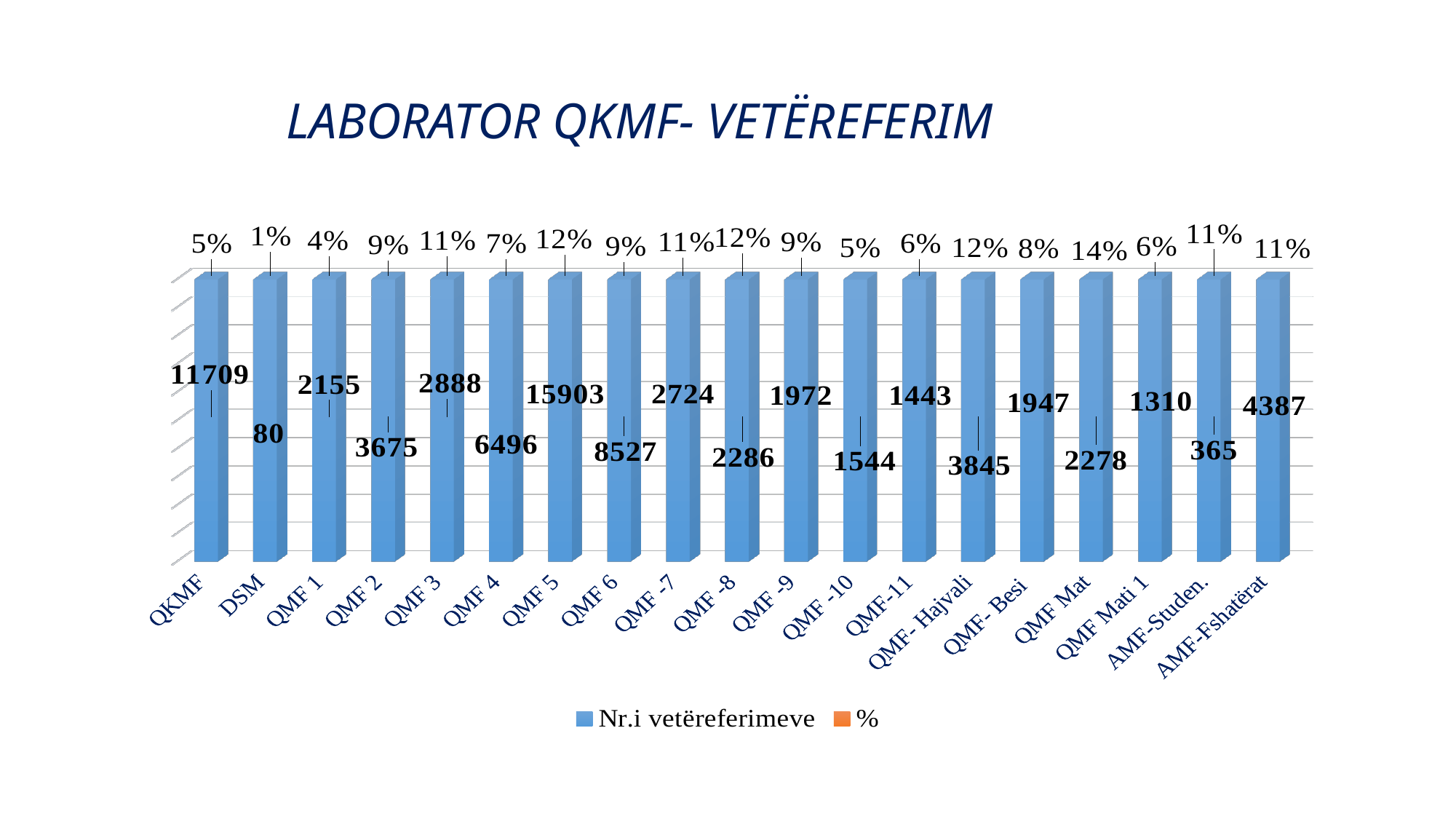
Which has more self-referrals, QMF 2 or QMF- Hajvali? QMF- Hajvali What is the number of self-referrals (Nr.i vetëreferimeve) for DSM? 80 What is the title of the chart? LABORATOR QKMF- VETËREFERIM What is the difference in the number of self-referrals between QKMF and QMF 6? 3182 What is the number of self-referrals for AMF-Fshatërat? 4387 Which category has the highest number of self-referrals according to the data labels? QMF 5 What percentage is shown for QMF Mat? 14% What kind of chart is shown on the slide? Bar chart What is the number of self-referrals (Nr.i vetëreferimeve) for QMF 5? 15903 How many series does the legend list? 2 How many categories are shown on the x axis? 19 Which category has the lowest number of self-referrals according to the data labels? DSM